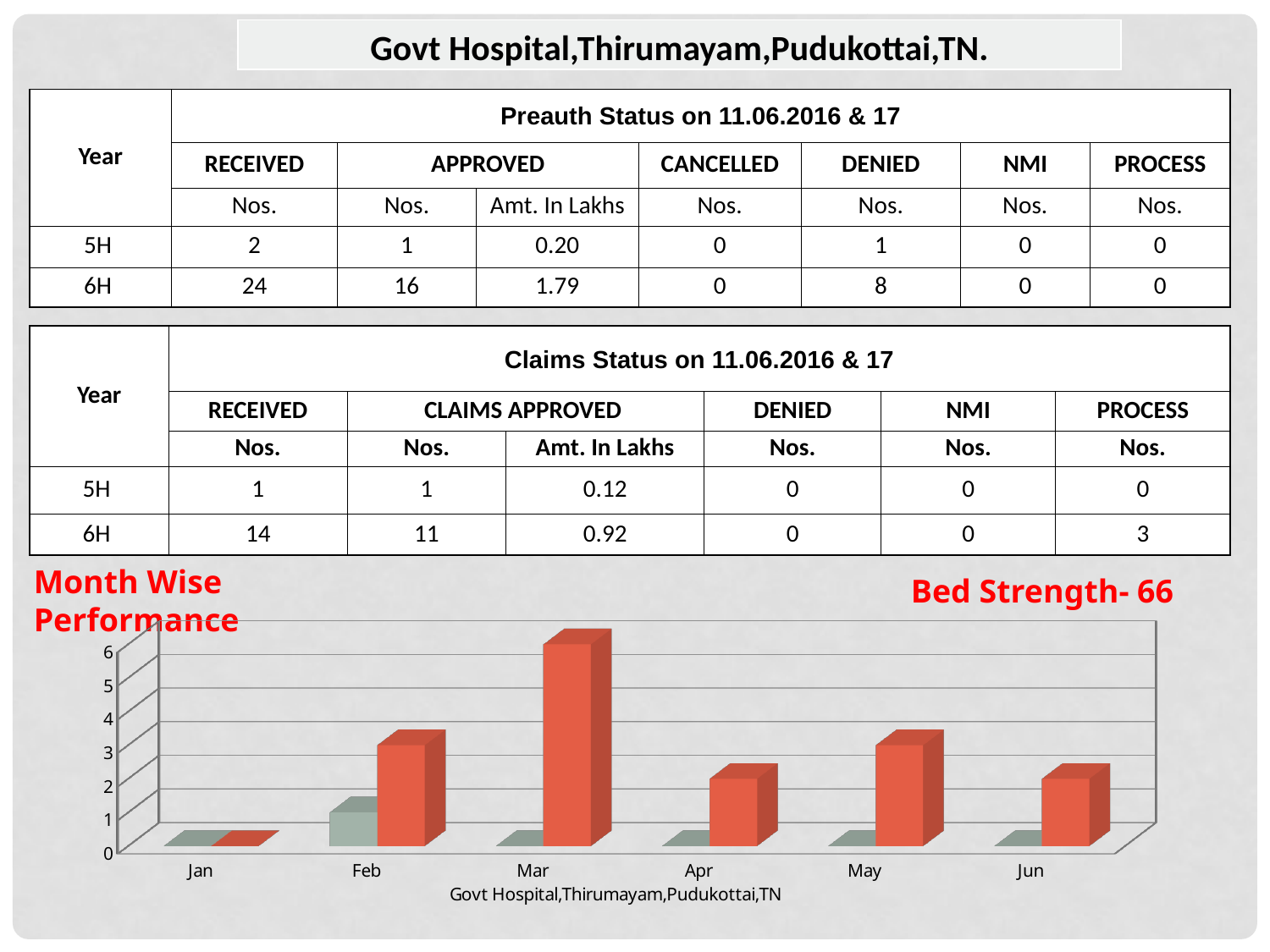
How many months are shown on the x axis of the Month Wise Performance chart? 6 In the Month Wise Performance chart, is the tallest bar for Feb greater or less than 4? less In the Month Wise Performance chart, which month has the taller bar, Mar or Feb? Mar Which month has the lowest bar in the Month Wise Performance chart? Jan What text appears below the x axis of the Month Wise Performance chart? Govt Hospital,Thirumayam,Pudukottai,TN In the Month Wise Performance chart, which month has the taller bar, Feb or Apr? Feb In the Month Wise Performance chart, does the value rise or fall from Mar to Apr? fall What kind of chart is shown at the bottom of the slide? bar chart In the Month Wise Performance chart, is the tallest bar for May greater or less than 2? greater In the Month Wise Performance chart, is the tallest bar for Apr greater or less than 3? less Which month has the highest bar in the Month Wise Performance chart? Mar